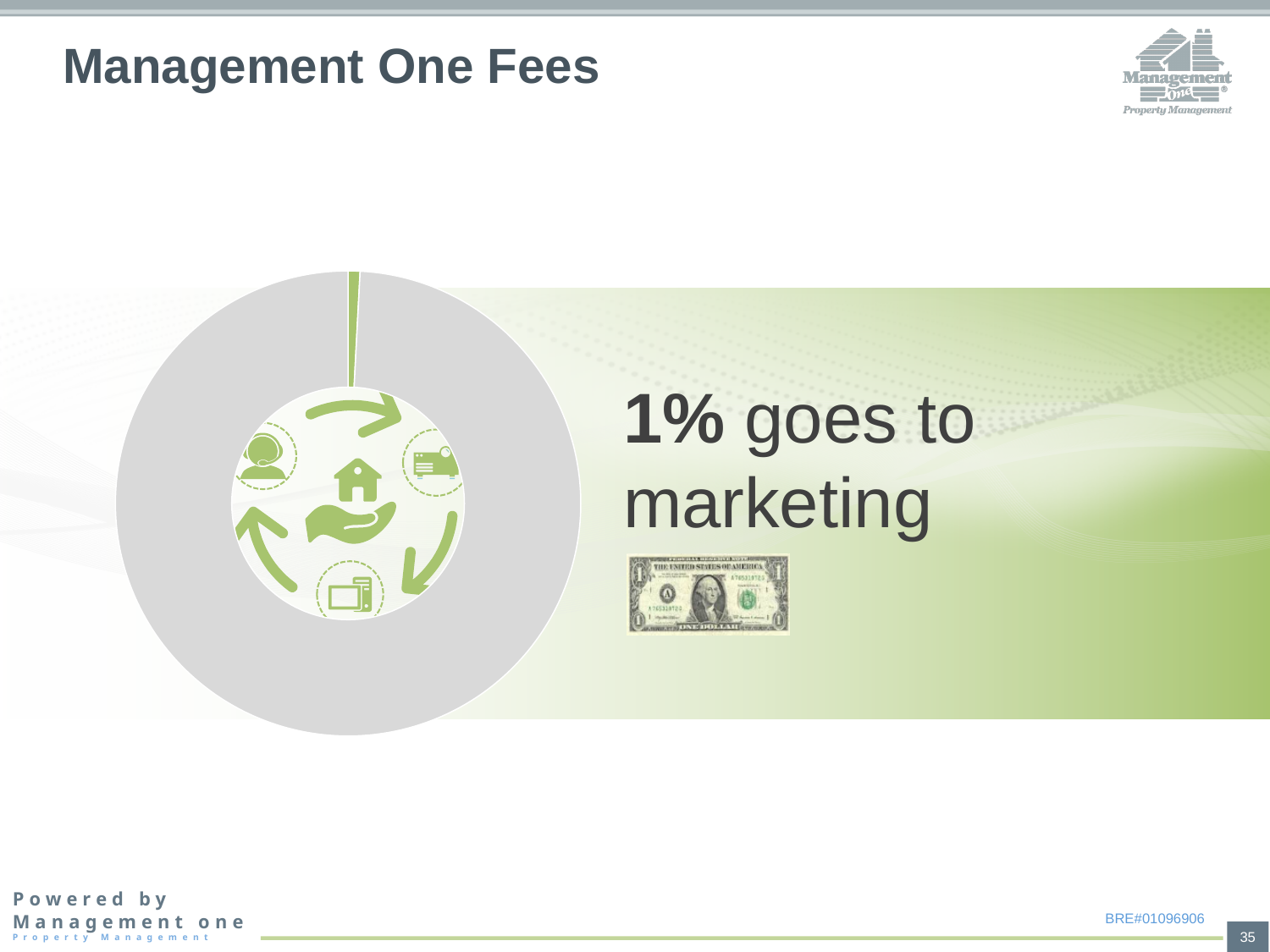
Which slice of the doughnut chart is larger, the green marketing slice or the gray slice? The gray slice What is the title of the slide containing the doughnut chart? Management One Fees Is the marketing share shown in the chart greater or less than 50%? less What colour is the marketing slice in the doughnut chart? Green Which slice of the doughnut chart is the smallest? The green marketing slice How many slices does the doughnut chart have? 2 What kind of chart is shown on the slide? Doughnut (pie) chart What share of the doughnut chart goes to marketing? 1%